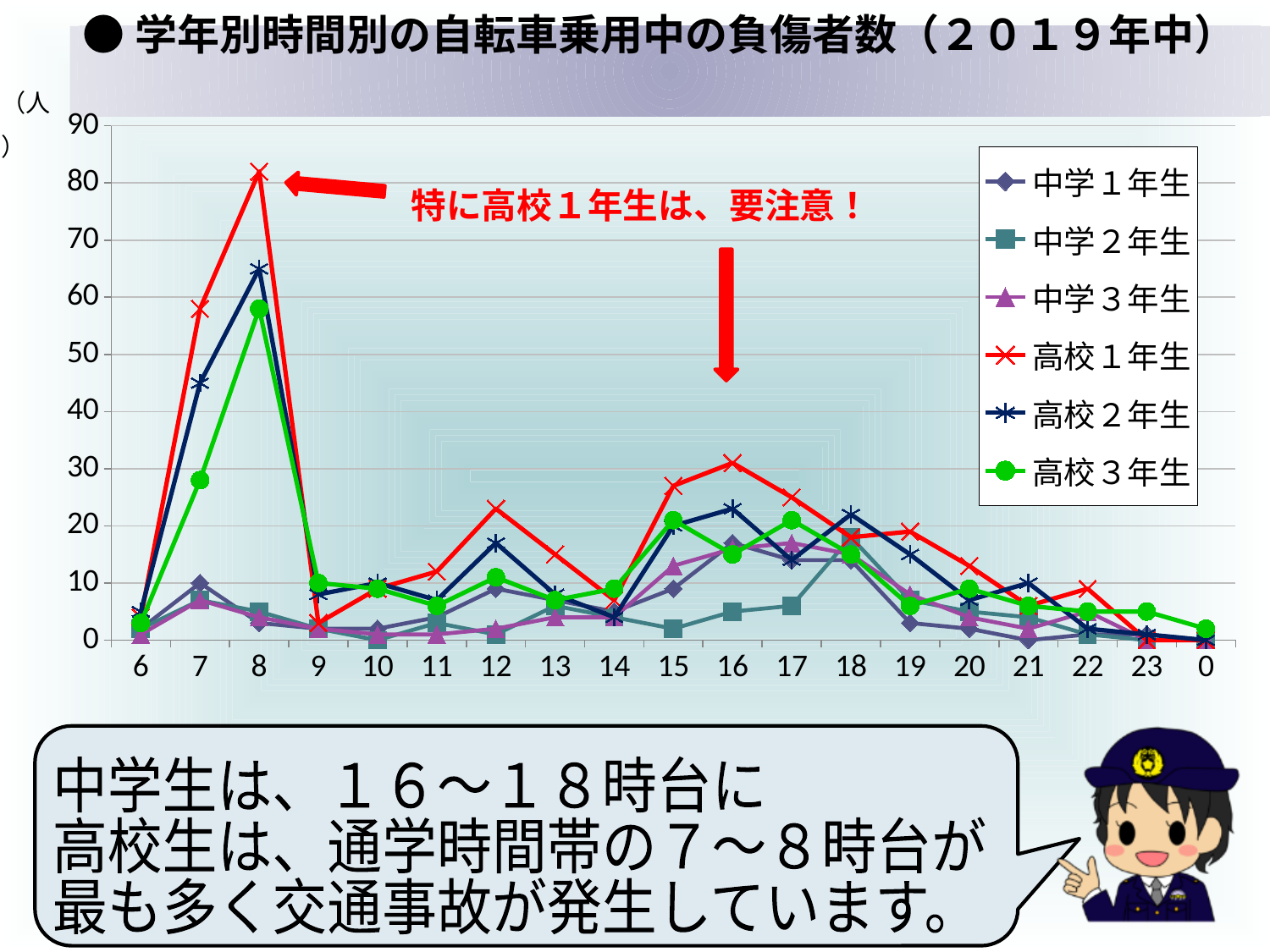
At which hour does the 高校１年生 series reach its highest value? 8 Does the 高校１年生 series rise or fall from hour 8 to hour 9? fall Is the value for 高校２年生 at hour 8 greater or less than 60? greater At hour 8, which is larger: the value for 高校１年生 or 高校３年生? 高校１年生 Is the value for 高校３年生 at hour 7 greater or less than 30? less What kind of chart is shown on the slide? line chart Is the value for 高校１年生 at hour 8 greater or less than 70? greater Which series reaches the highest value anywhere on the chart? 高校１年生 What colour is the line for 高校１年生? red How many series does the legend list? 6 At hour 7, which is larger: the value for 高校２年生 or 高校３年生? 高校２年生 How many hour categories are shown on the x axis? 19